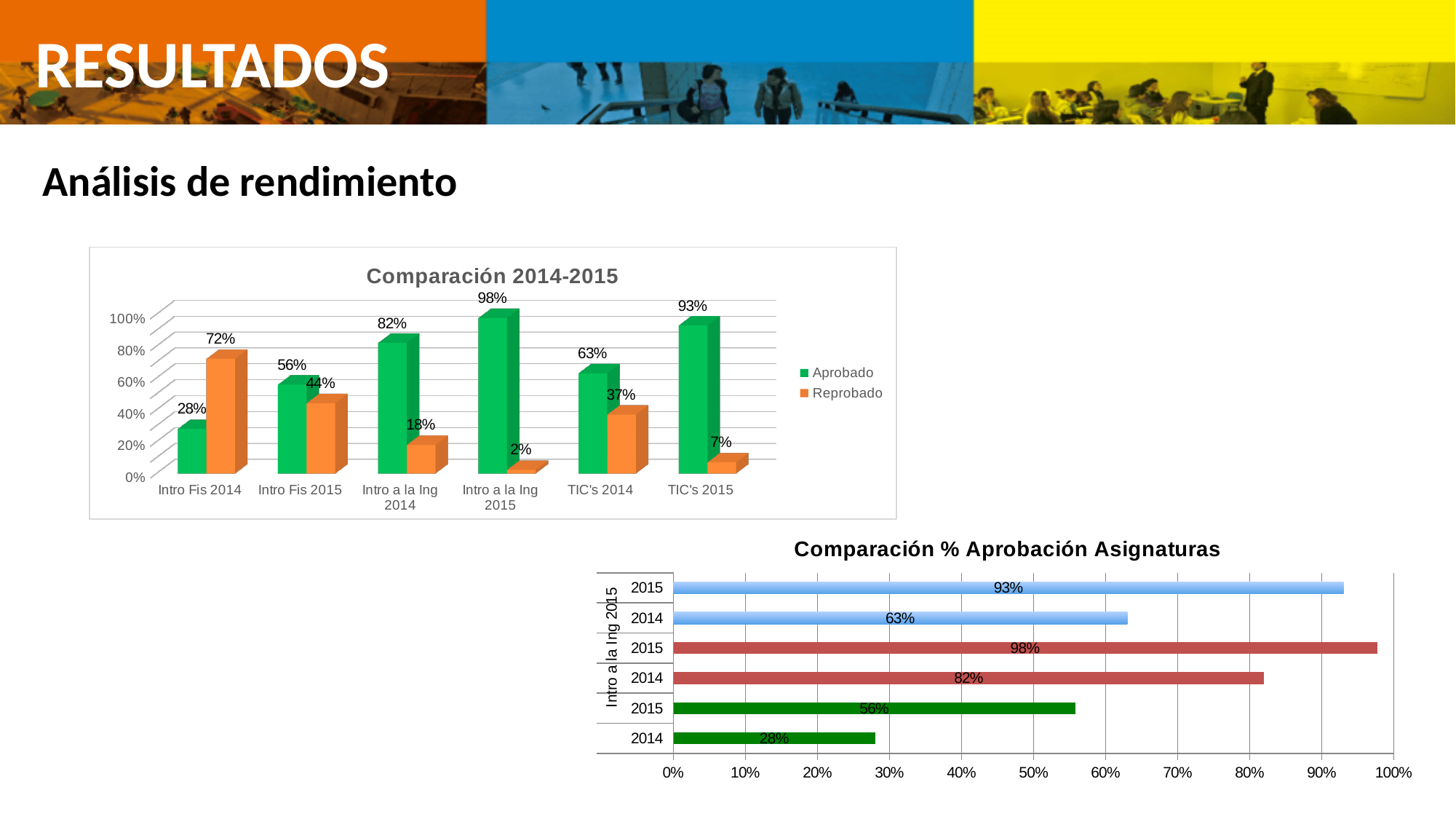
What kind of chart is the one titled "Comparación % Aprobación Asignaturas"? Bar chart In the chart titled "Comparación 2014-2015", which is larger for Intro Fis 2015: Aprobado or Reprobado? Aprobado In the chart titled "Comparación 2014-2015", which category has the lowest Reprobado value? Intro a la Ing 2015 In the chart titled "Comparación % Aprobación Asignaturas", what is the value of the bottom bar labelled 2014? 28% In the chart titled "Comparación 2014-2015", what is the Aprobado value for Intro a la Ing 2015? 98% In the chart titled "Comparación 2014-2015", what is the Reprobado value for Intro Fis 2014? 72% In the chart titled "Comparación 2014-2015", what is the Reprobado value for TIC's 2015? 7% In the chart titled "Comparación 2014-2015", what is the difference between the Aprobado values for TIC's 2015 and TIC's 2014? 30% In the chart titled "Comparación 2014-2015", which category has the highest Aprobado value? Intro a la Ing 2015 In the chart titled "Comparación % Aprobación Asignaturas", what is the value of the longest bar? 98% In the chart titled "Comparación 2014-2015", how many categories are shown on the x axis? 6 In the chart titled "Comparación 2014-2015", how many series does the legend list? 2